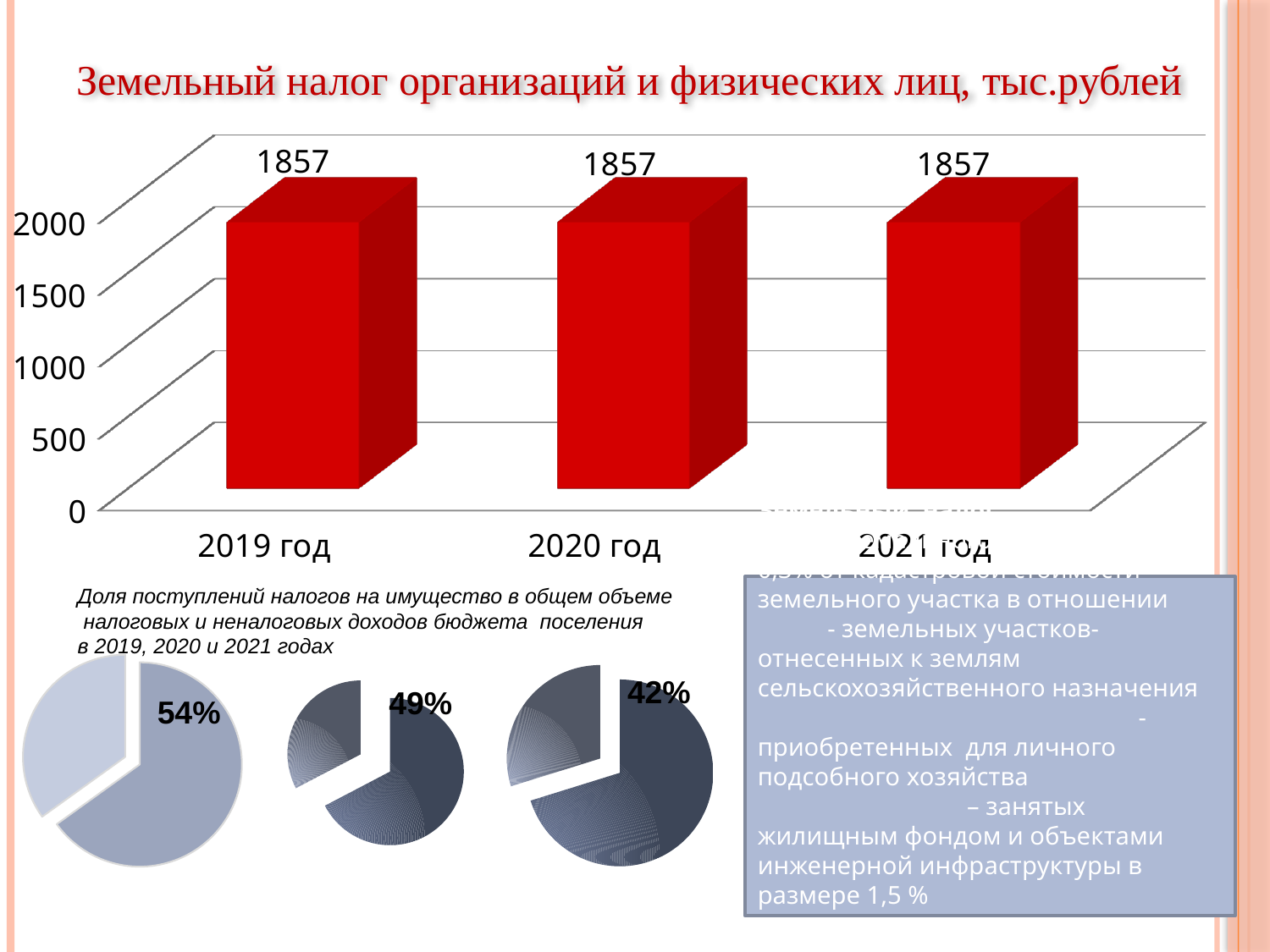
On the bar chart, what is the difference between the values for 2019 год and 2021 год? 0 On the middle pie chart at the bottom of the slide, what share is labelled? 49% On the bar chart, is the value for 2020 год greater or less than 1500? greater What kind of chart is the large chart at the top of the slide? bar chart What is the title of the bar chart? Земельный налог организаций и физических лиц, тыс.рублей On the right pie chart at the bottom of the slide, what share is labelled? 42% On the bar chart, what is the value for 2021 год? 1857 On the bar chart, do the values rise, fall or stay the same from 2019 год to 2021 год? stay the same On the left pie chart at the bottom of the slide, what share is labelled on the highlighted slice? 54% On the bar chart, how many categories (years) are shown? 3 On the bar chart, what is the value for 2019 год? 1857 On the bar chart, what is the value for 2020 год? 1857